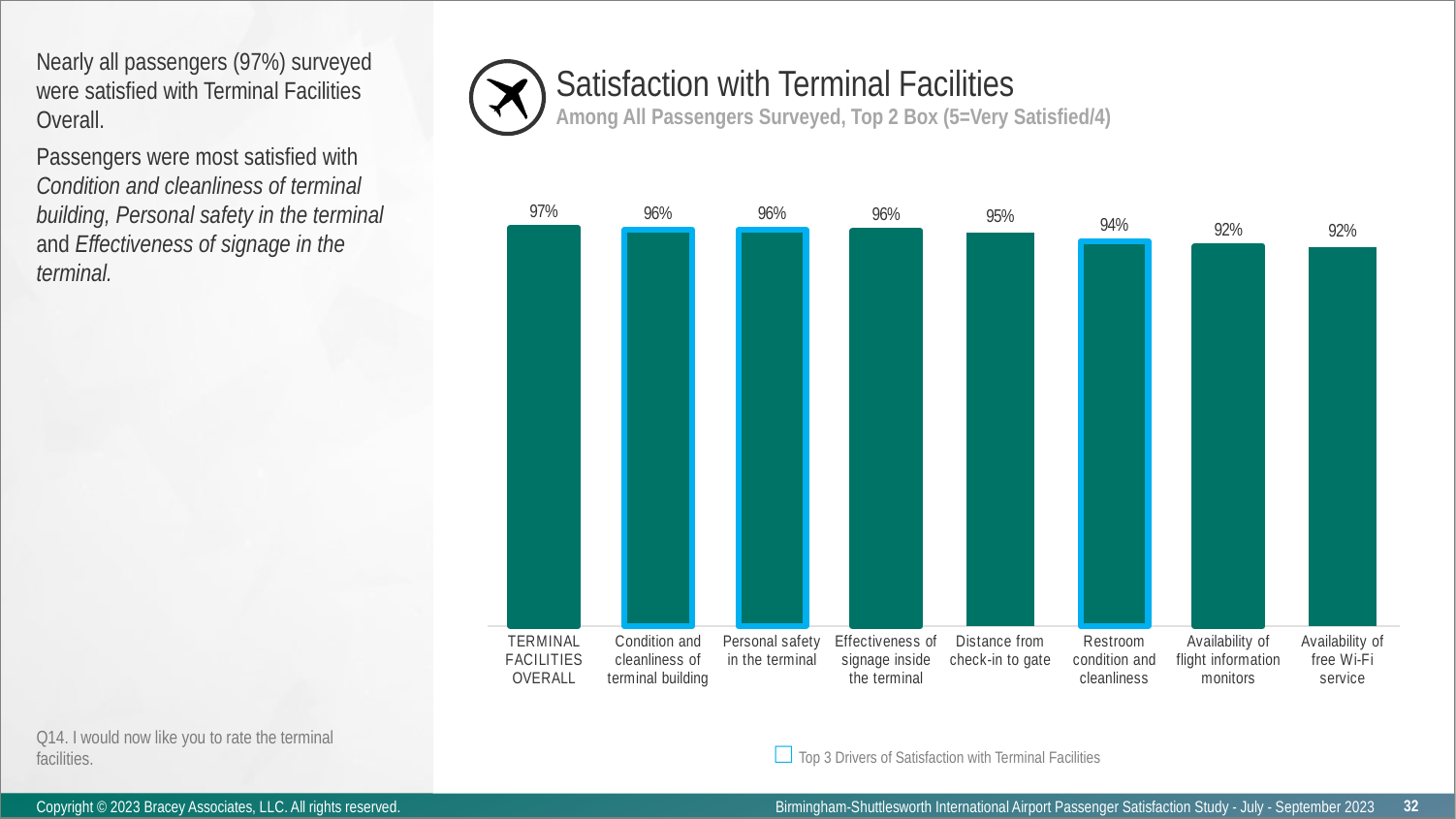
What is the Top 2 Box satisfaction value for Terminal Facilities Overall? 97% How many bars are outlined in blue as Top 3 Drivers of Satisfaction with Terminal Facilities? 3 What is the difference between the values for Distance from check-in to gate and Restroom condition and cleanliness? 1% Do the values rise or fall from left to right across the chart? Fall Which category has the highest satisfaction value? Terminal Facilities Overall What is the difference between the values for Terminal Facilities Overall and Availability of free Wi-Fi service? 5% What is the value for Distance from check-in to gate? 95% How many categories are shown in the chart? 8 What is the value for Restroom condition and cleanliness? 94% What is the value for Availability of free Wi-Fi service? 92% Which is larger, the value for Personal safety in the terminal or the value for Availability of flight information monitors? Personal safety in the terminal What kind of chart is shown on the slide? Bar chart